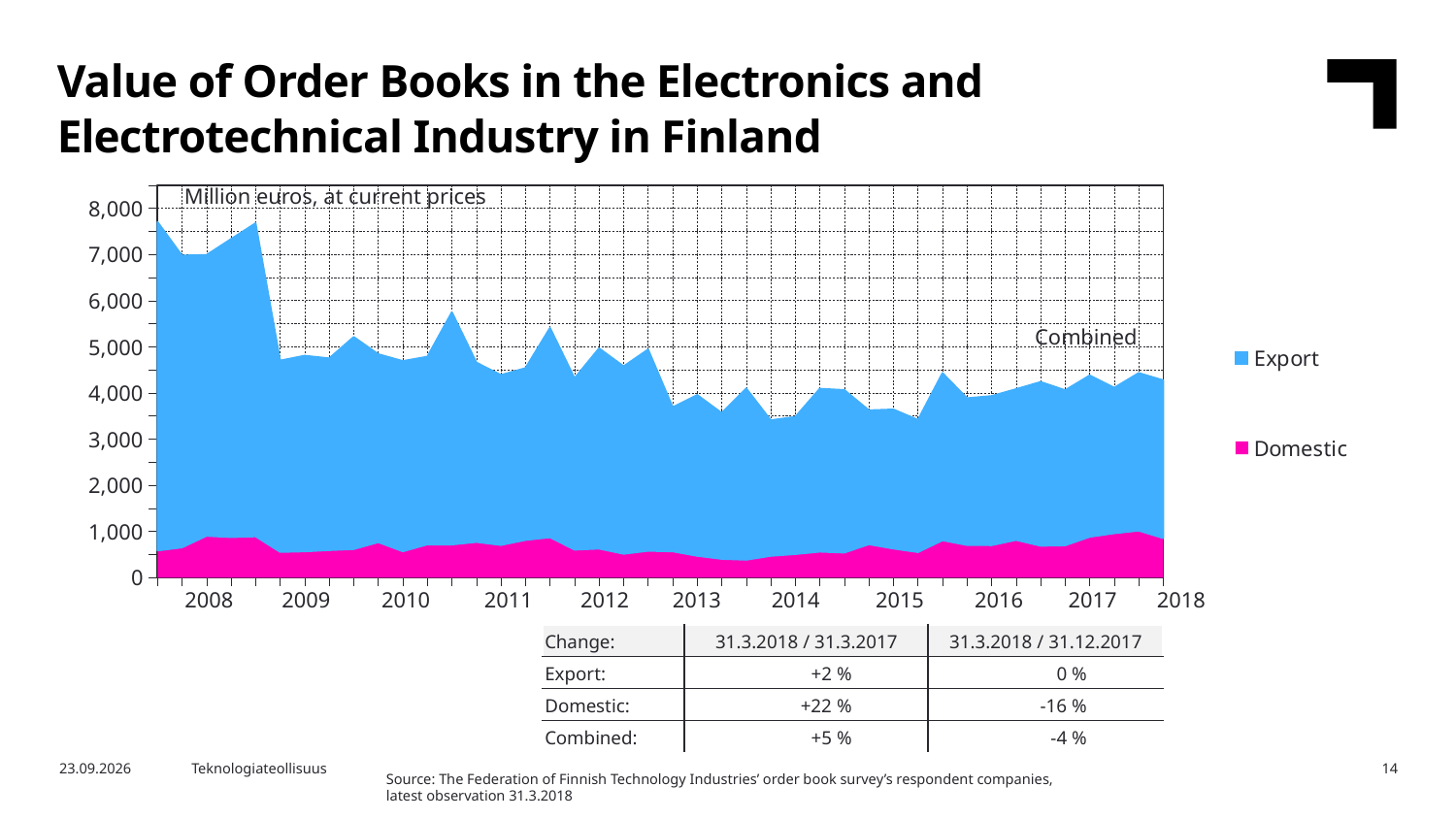
Does the combined value of order books rise or fall overall from 2008 to 2018? Fall Is the combined value of order books at the 2018 end of the chart greater or less than 5,000? less Is the combined value of order books at the start of 2008 greater or less than 7,000? greater In which year does the combined value of order books reach its highest level? 2008 What unit is stated at the top of the chart area? Million euros, at current prices Is the Domestic value at the 2018 end of the chart greater or less than 2,000? less How many series does the chart legend list? 2 Which series, Export or Domestic, has the larger values throughout the chart? Export How many year labels are shown on the x axis? 11 What are the two series named in the chart legend? Export and Domestic What kind of chart is shown on the slide? Area chart